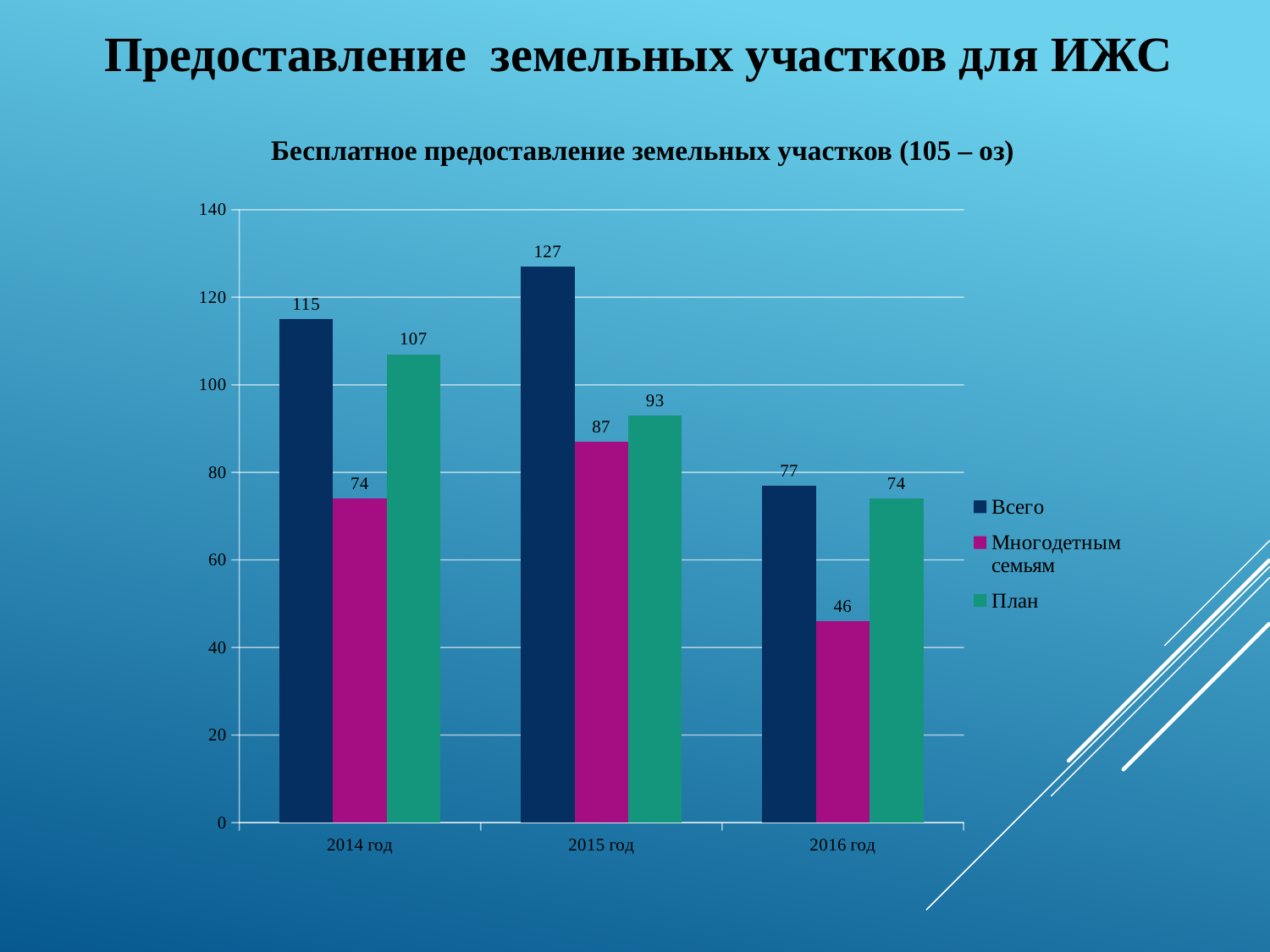
What is the difference between Всего and Многодетным семьям in 2015 год? 40 What is the title of the chart? Бесплатное предоставление земельных участков (105 – оз) How many years are shown on the x axis? 3 What is the value for Всего in 2014 год? 115 What is the value for Многодетным семьям in 2016 год? 46 Which year has the highest value for Всего? 2015 год What is the value for План in 2015 год? 93 How many series does the legend list? 3 Which is larger in 2014 год: Всего or План? Всего Which year has the lowest value for План? 2016 год What kind of chart is shown on the slide? bar chart Is the value for Всего in 2016 год greater or less than 80? less